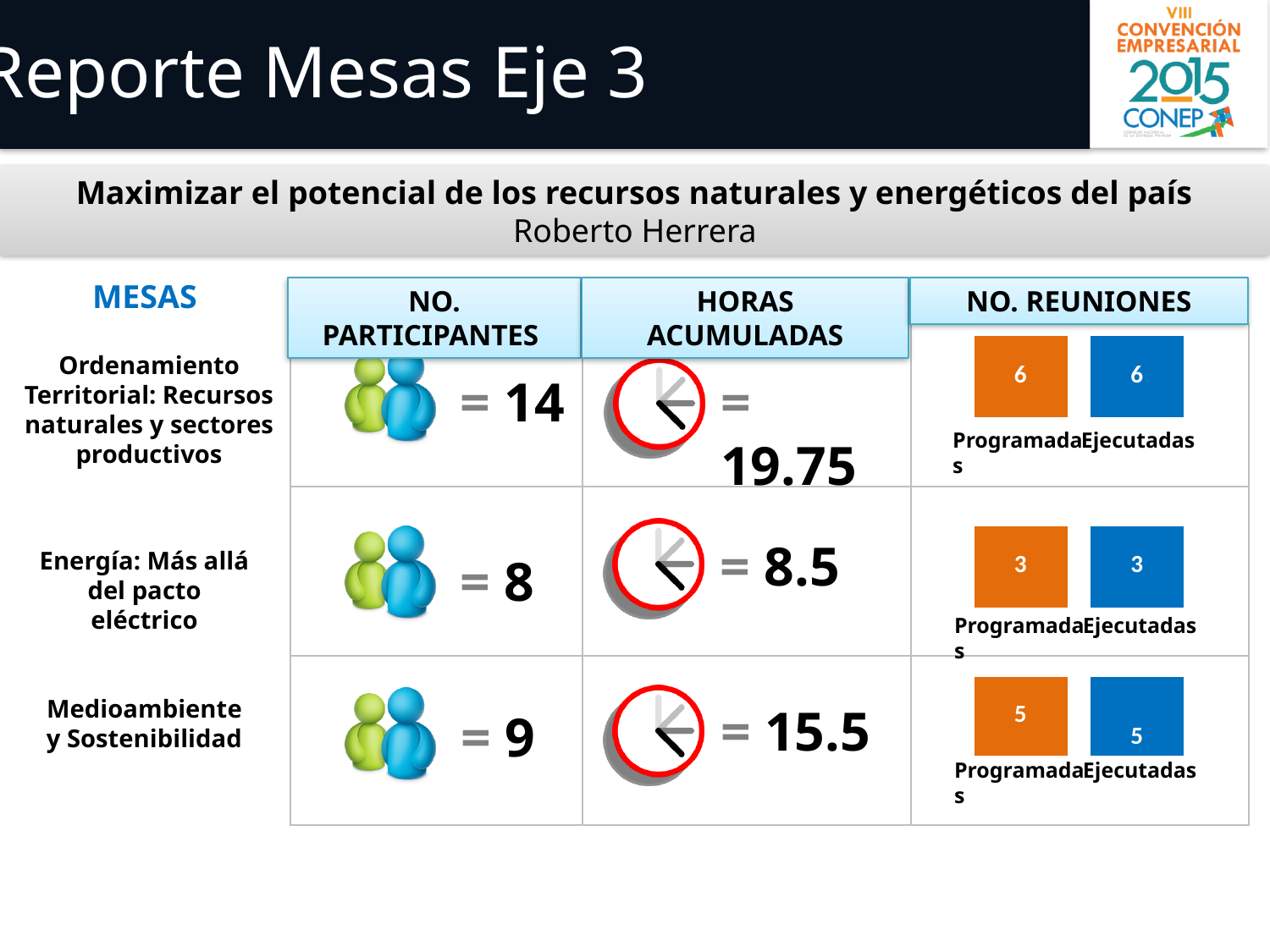
What colour is the Ejecutadas bar in the NO. REUNIONES charts? Blue In the NO. REUNIONES chart for the Medioambiente y Sostenibilidad row, what is the difference between Programadas and Ejecutadas? 0 In the NO. REUNIONES chart for the Medioambiente y Sostenibilidad row, what is the value for Ejecutadas? 5 In the NO. REUNIONES chart for the Ordenamiento Territorial row, what is the value for Programadas? 6 In the NO. REUNIONES chart for the Medioambiente y Sostenibilidad row, what is the value for Programadas? 5 What kind of chart is used in the NO. REUNIONES column? Bar chart In the NO. REUNIONES chart for the Ordenamiento Territorial row, what is the difference between Programadas and Ejecutadas? 0 How many bars does the NO. REUNIONES chart for the Energía row have? 2 In the NO. REUNIONES chart for the Energía: Más allá del pacto eléctrico row, what is the value for Programadas? 3 What colour is the Programadas bar in the NO. REUNIONES charts? Orange In the NO. REUNIONES chart for the Energía: Más allá del pacto eléctrico row, what is the value for Ejecutadas? 3 In the NO. REUNIONES chart for the Ordenamiento Territorial row, what is the value for Ejecutadas? 6